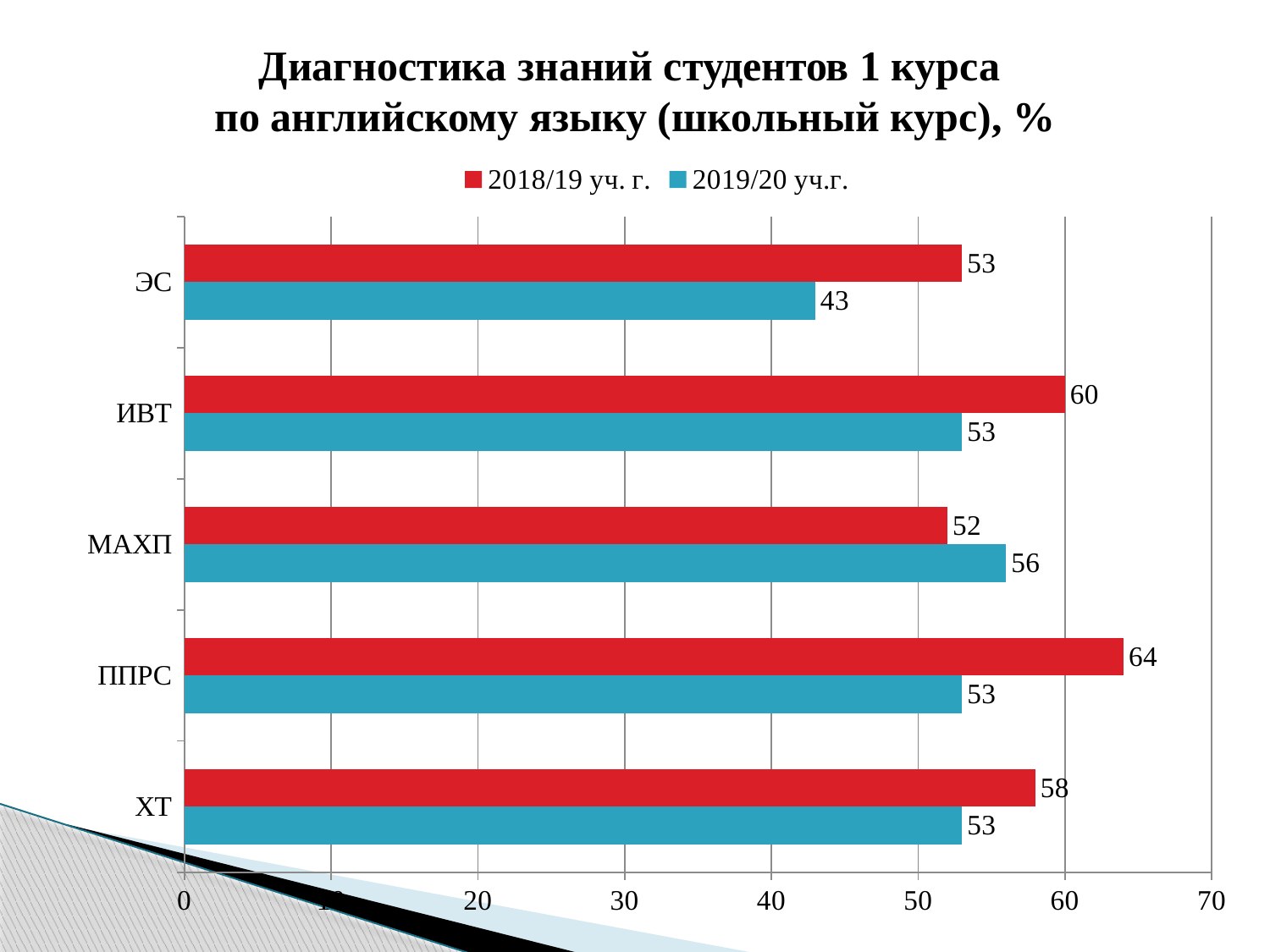
What is the value for ЭС in the 2019/20 уч.г. series? 43 How many categories are shown on the chart? 5 For МАХП, which series has the larger value, 2018/19 уч. г. or 2019/20 уч.г.? 2019/20 уч.г. What is the difference between the 2018/19 уч. г. and 2019/20 уч.г. values for ППРС? 11 What is the value for ИВТ in the 2018/19 уч. г. series? 60 Is the value for ХТ in the 2018/19 уч. г. series greater or less than 50? greater Which category has the highest value in the 2018/19 уч. г. series? ППРС What colour represents the 2019/20 уч.г. series? blue Which category has the lowest value in the 2019/20 уч.г. series? ЭС What kind of chart is shown on the slide? bar chart How many series does the legend list? 2 What is the value for МАХП in the 2019/20 уч.г. series? 56